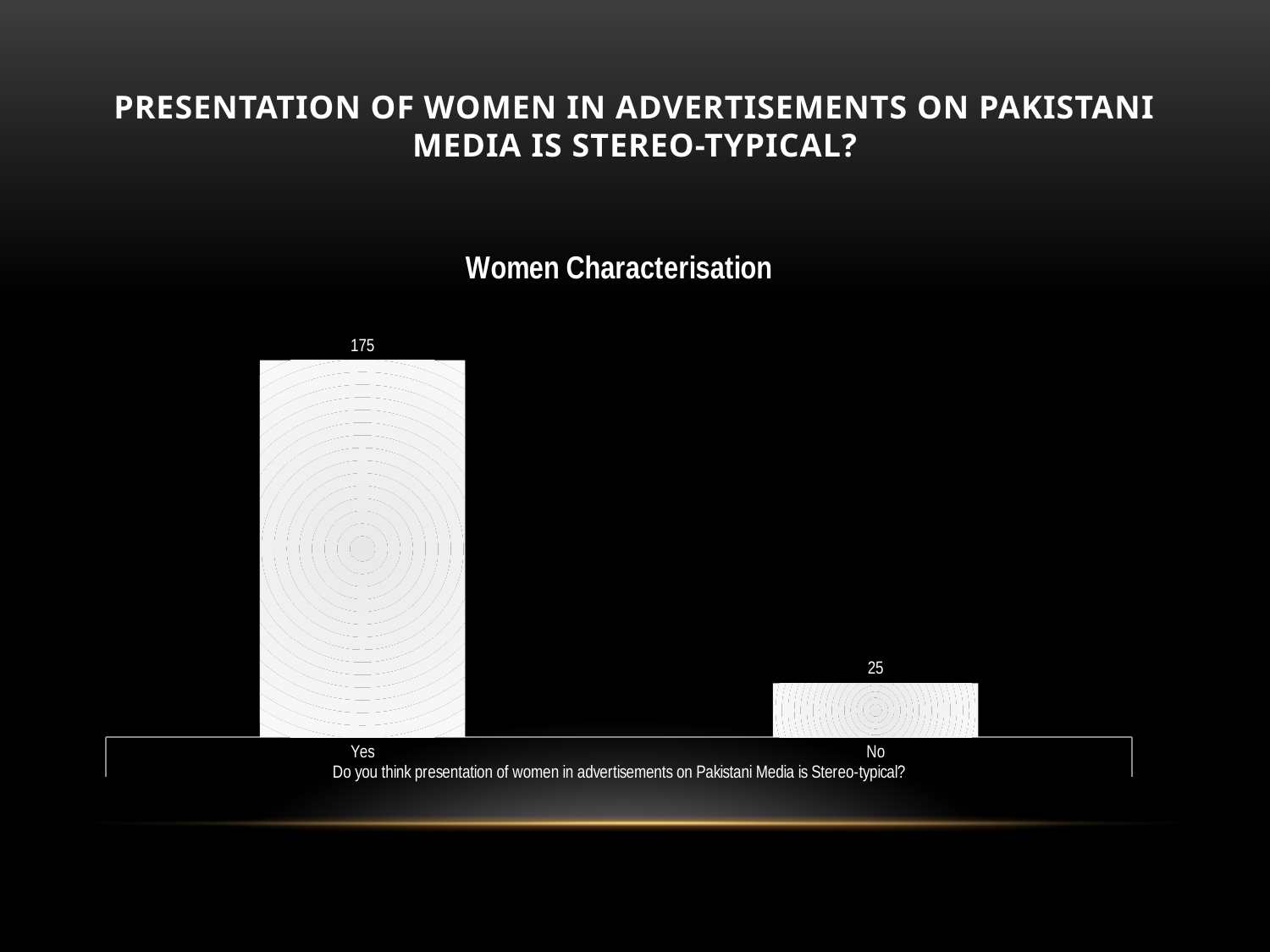
Which category has the highest value? Yes What is the difference between the values for Yes and No? 150 What is the title of the chart? Women Characterisation What is the x-axis title of the chart? Do you think presentation of women in advertisements on Pakistani Media is Stereo-typical? What is the total of the two values shown in the chart? 200 What is the value for No? 25 How many categories are shown in the chart? 2 What is the value for Yes? 175 Which category has the lowest value? No What kind of chart is shown on the slide? Bar chart Which is larger, the value for Yes or the value for No? Yes